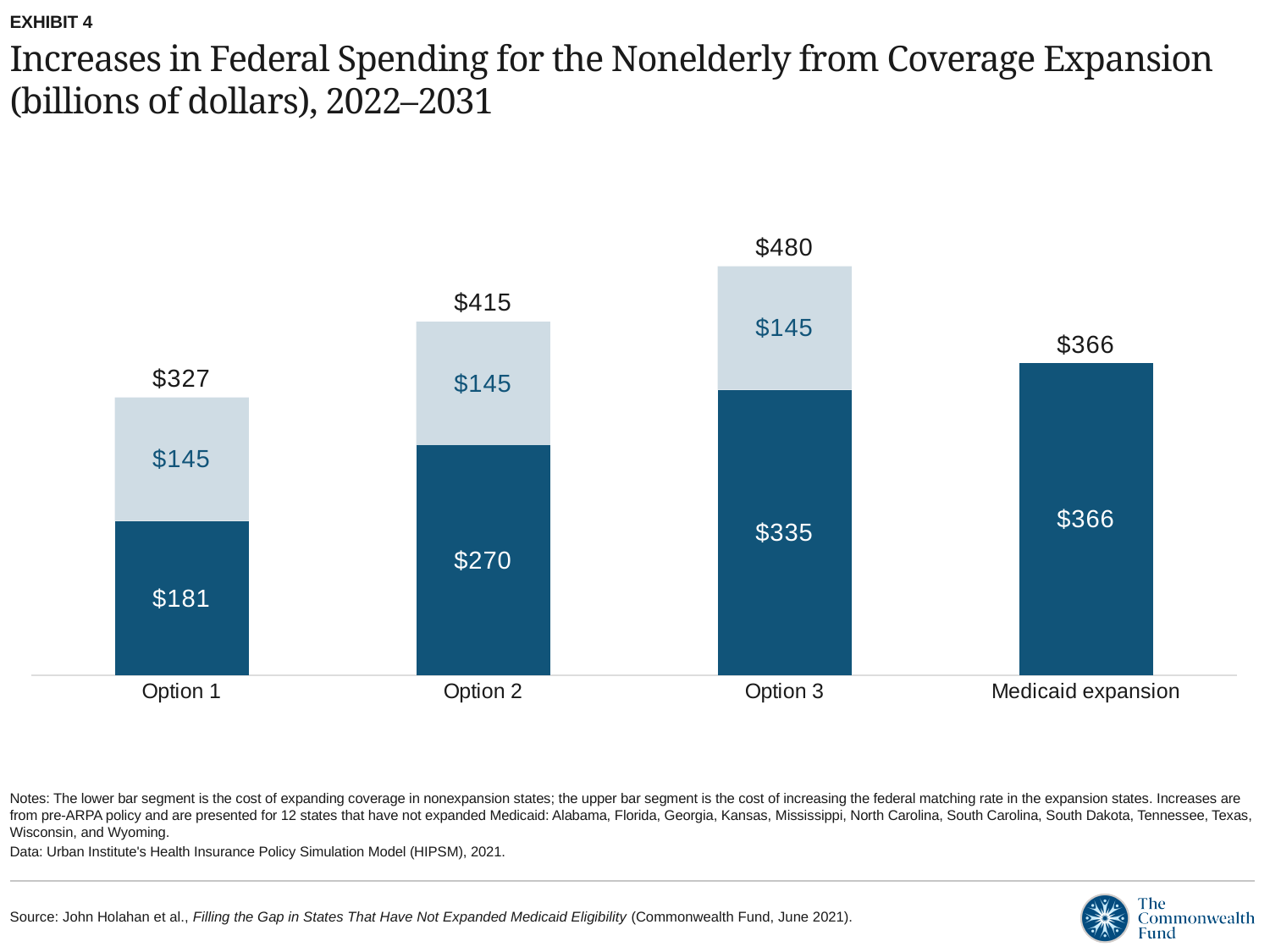
How many categories are shown on the x axis? 4 What is the total value shown above the bar for Option 1? $327 Which category has the lowest total? Option 1 Which is larger, the total for Option 2 or the value for Medicaid expansion? Option 2 What is the value of the lower (dark) segment for Option 2? $270 What is the value shown for Medicaid expansion? $366 Do the totals rise or fall from Option 1 to Option 3? Rise What is the difference between the totals for Option 3 and Option 2? $65 What is the difference between the lower segments of Option 2 and Option 1? $89 What is the value of the upper (light) segment for Option 3? $145 What kind of chart is shown on the slide? Stacked bar chart Which category has the highest total? Option 3